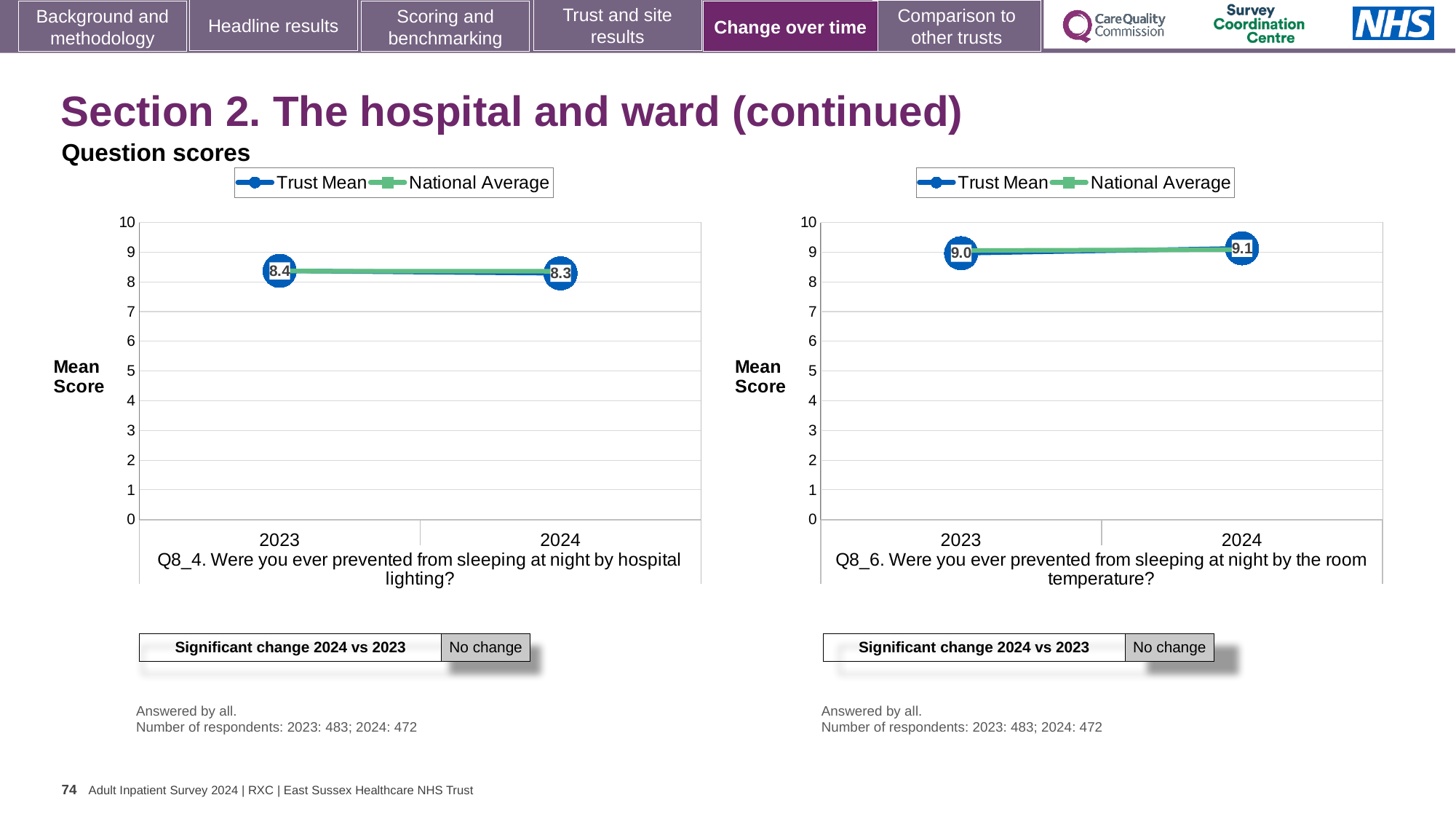
In the Q8_4 chart (left), what is the Trust Mean score for 2024? 8.3 What kind of chart is the Q8_4 chart (left)? line chart How many years are plotted on the x axis of the Q8_6 chart (right)? 2 In the Q8_6 chart (right), does the Trust Mean rise or fall from 2023 to 2024? rise In the Q8_4 chart (left), does the Trust Mean rise or fall from 2023 to 2024? fall In the Q8_4 chart (left), what is the Trust Mean score for 2023? 8.4 In the Q8_4 chart (left), is the Trust Mean score for 2023 greater or less than 8? greater How many series does the legend of the Q8_4 chart (left) list? 2 In the Q8_6 chart (right), what is the Trust Mean score for 2024? 9.1 In the Q8_6 chart (right), what is the Trust Mean score for 2023? 9.0 In the Q8_4 chart (left), what is the difference between the Trust Mean scores for 2023 and 2024? 0.1 In the Q8_6 chart (right), what is the difference between the Trust Mean scores for 2024 and 2023? 0.1